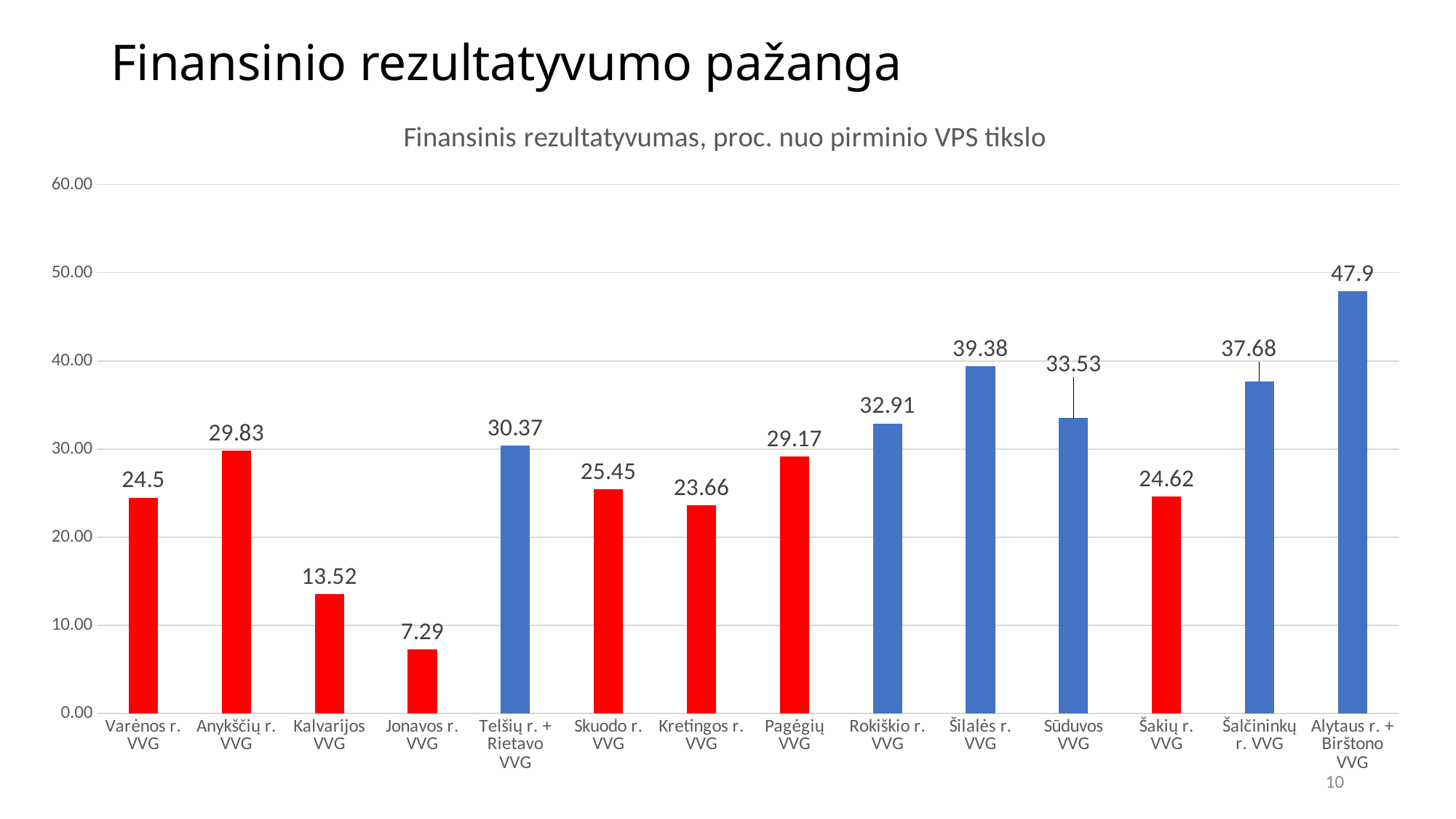
What is the value for Šilalės r. VVG? 39.38 How many categories are shown on the x axis? 14 Is the value for Kalvarijos VVG greater or less than 20.00? less Which category has the lowest value? Jonavos r. VVG What is the value for Telšių r. + Rietavo VVG? 30.37 What is the difference between the values for Šalčininkų r. VVG and Sūduvos VVG? 4.15 Which is larger, the value for Anykščių r. VVG or the value for Pagėgių VVG? Anykščių r. VVG What is the title of the chart? Finansinis rezultatyvumas, proc. nuo pirminio VPS tikslo What is the difference between the values for Alytaus r. + Birštono VVG and Jonavos r. VVG? 40.61 What kind of chart is shown on the slide? bar chart Which category has the highest value? Alytaus r. + Birštono VVG What is the value for Jonavos r. VVG? 7.29